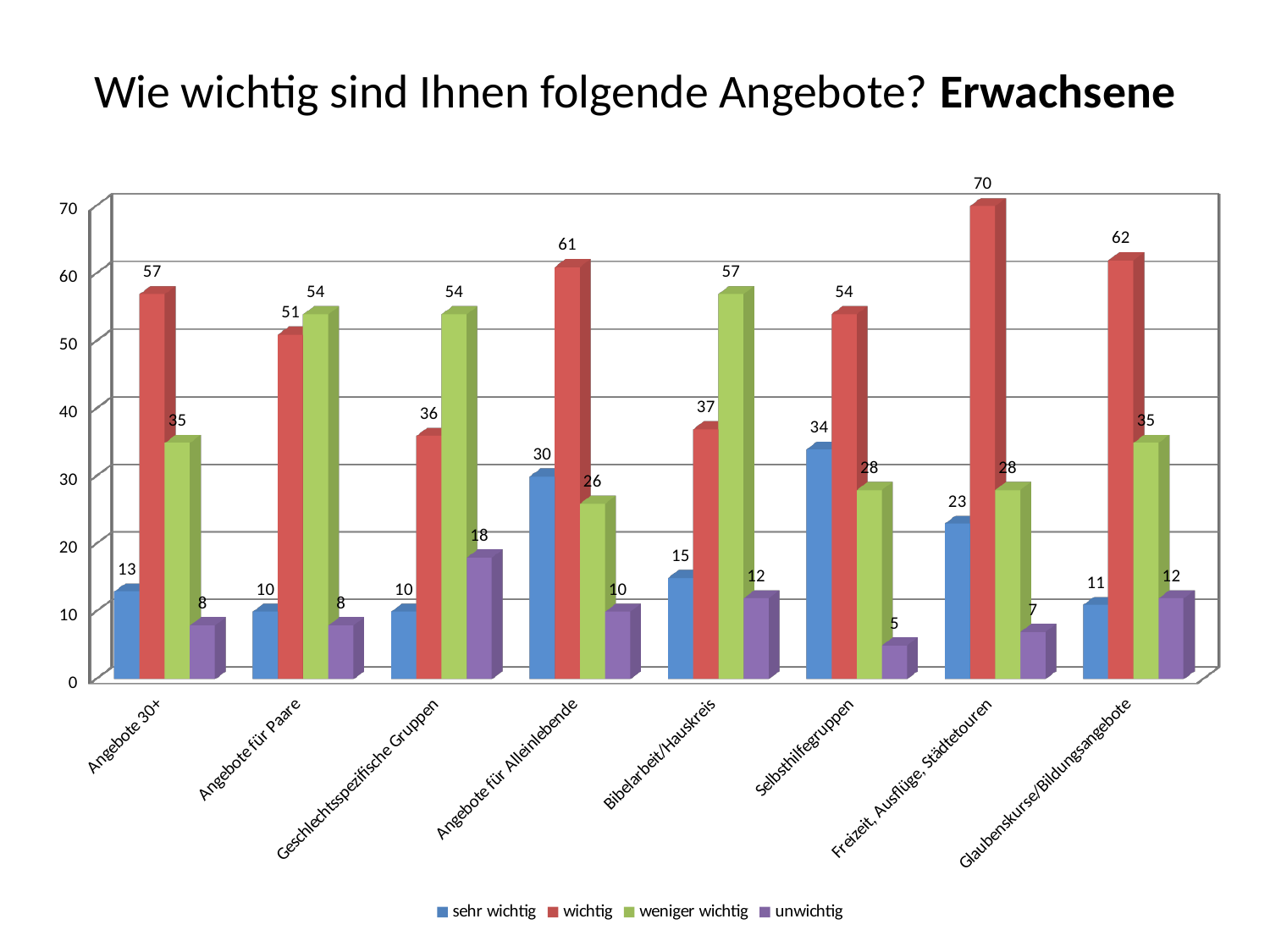
Is the "weniger wichtig" value for Angebote für Paare greater or less than 50? greater How many categories are shown on the x axis? 8 What kind of chart is shown on the slide? bar chart What is the difference between the "wichtig" value for Freizeit, Ausflüge, Städtetouren and the "wichtig" value for Angebote 30+? 13 What is the value for "wichtig" for Angebote für Alleinlebende? 61 Which category has the highest value for "wichtig"? Freizeit, Ausflüge, Städtetouren How many series does the legend list? 4 Which category has the lowest value for "unwichtig"? Selbsthilfegruppen What is the value for "sehr wichtig" for Selbsthilfegruppen? 34 What is the value for "unwichtig" for Geschlechtsspezifische Gruppen? 18 Which colour represents the "unwichtig" series? purple Which is larger for Bibelarbeit/Hauskreis: the "wichtig" value or the "weniger wichtig" value? weniger wichtig